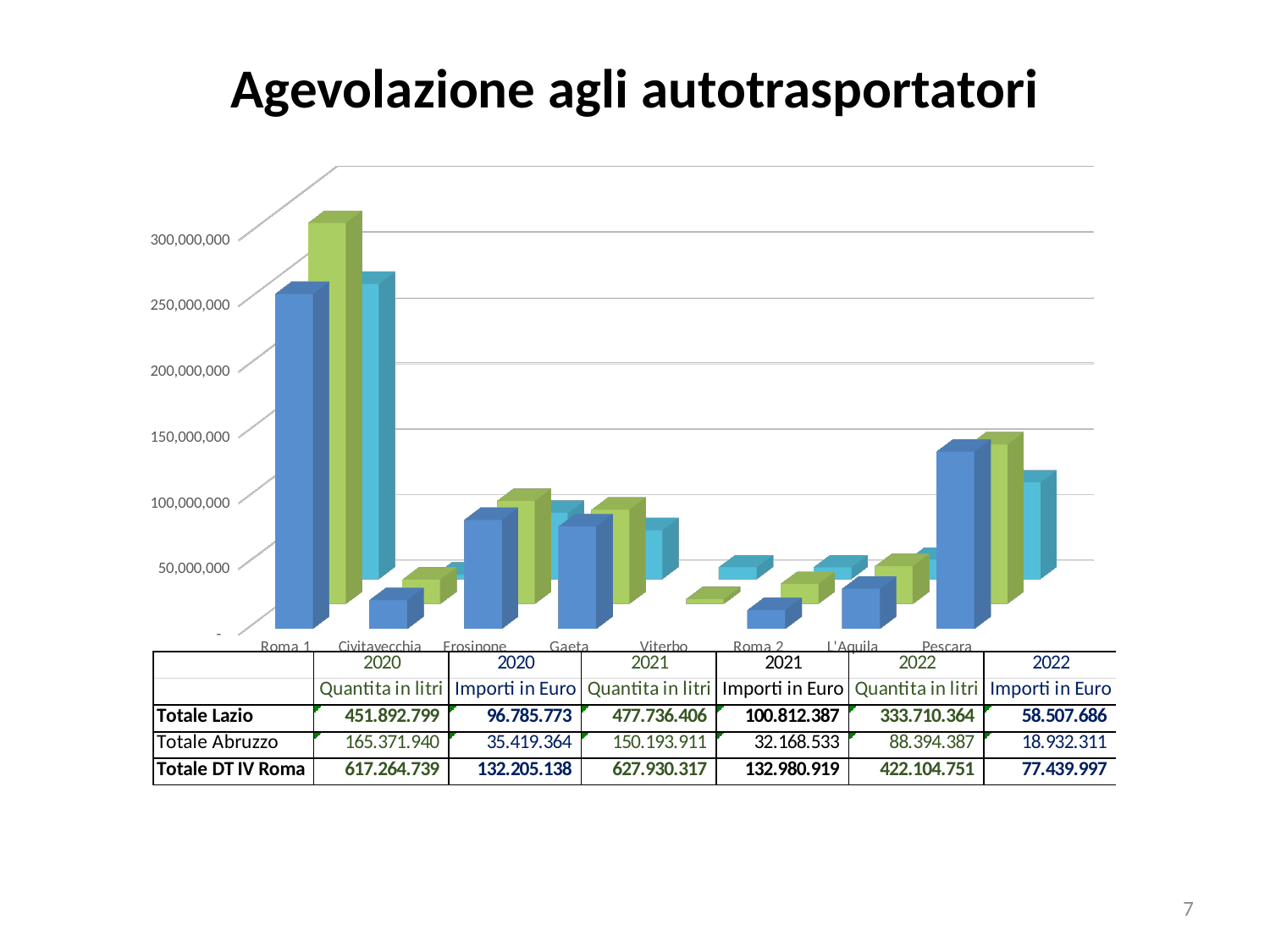
How many bars are drawn for each category in the chart? 3 Which category has the smallest bars in the chart? Viterbo How many categories are shown along the x axis of the chart? 8 Which category has the larger blue bar, Roma 1 or Pescara? Roma 1 Is the value of the blue bar for Roma 1 greater or less than 200,000,000? greater Is the value of the blue bar for Pescara greater or less than 100,000,000? greater Which category has the tallest bars in the chart? Roma 1 What kind of chart is shown on the slide? bar chart Is the value of the green bar for Frosinone greater or less than 50,000,000? greater Which category has the larger blue bar, Frosinone or Viterbo? Frosinone What is the title of the slide containing the chart? Agevolazione agli autotrasportatori